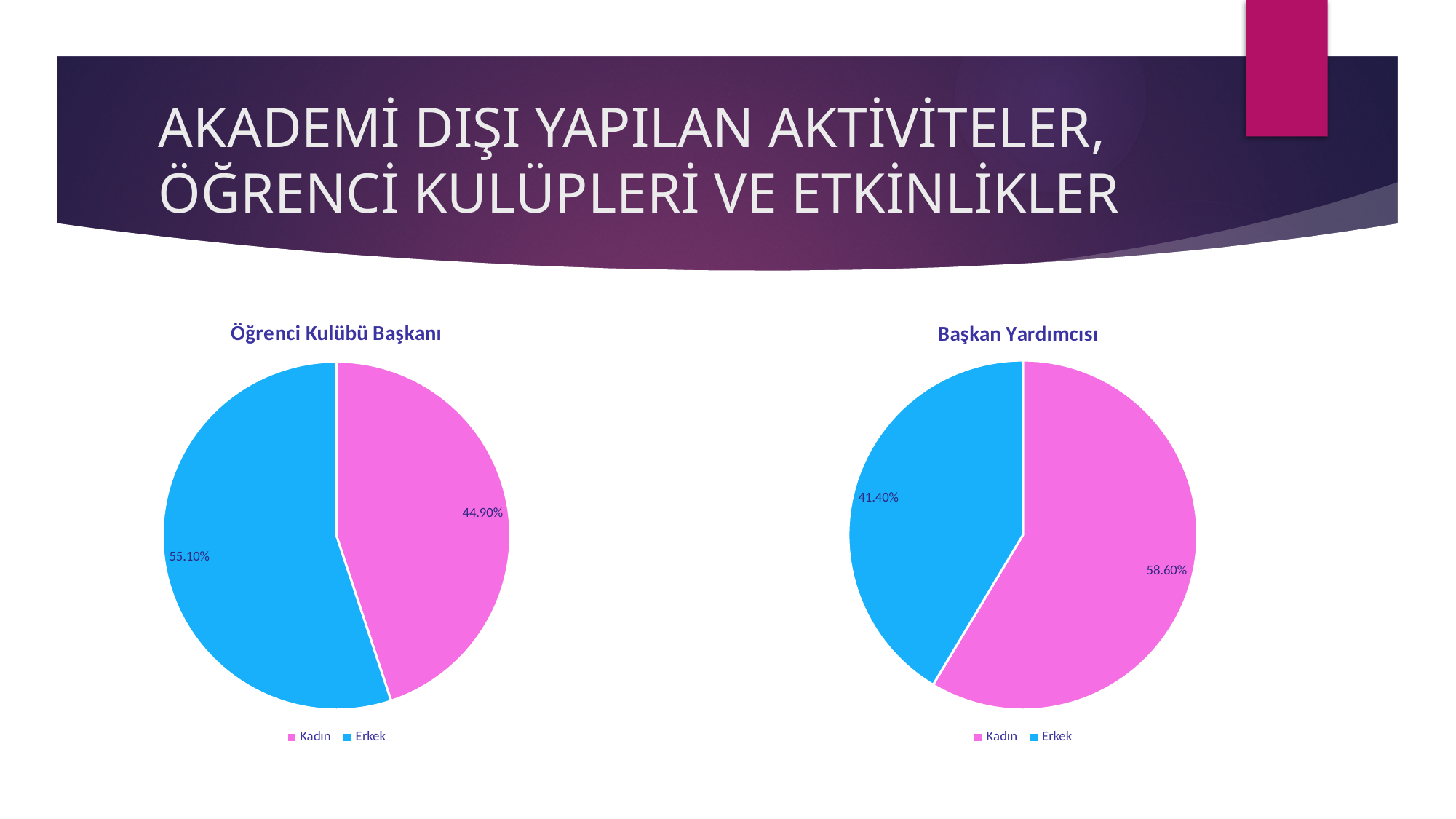
In the 'Başkan Yardımcısı' chart, what is the difference between the Kadın and Erkek shares? 17.20% In the 'Başkan Yardımcısı' chart, what is the value for Erkek? 41.40% In the 'Öğrenci Kulübü Başkanı' chart, which category has the largest share? Erkek In the 'Başkan Yardımcısı' chart, which is larger, Kadın or Erkek? Kadın In the 'Öğrenci Kulübü Başkanı' chart, which colour represents Kadın? Pink In the 'Öğrenci Kulübü Başkanı' chart, what is the difference between the Erkek and Kadın shares? 10.20% In the 'Başkan Yardımcısı' chart, what is the value for Kadın? 58.60% In the 'Öğrenci Kulübü Başkanı' chart, what is the value for Kadın? 44.90% In the 'Başkan Yardımcısı' chart, which category has the smallest share? Erkek What kind of chart is the 'Öğrenci Kulübü Başkanı' chart? Pie chart In the 'Öğrenci Kulübü Başkanı' chart, what is the value for Erkek? 55.10% How many slices does the 'Başkan Yardımcısı' pie chart have? 2